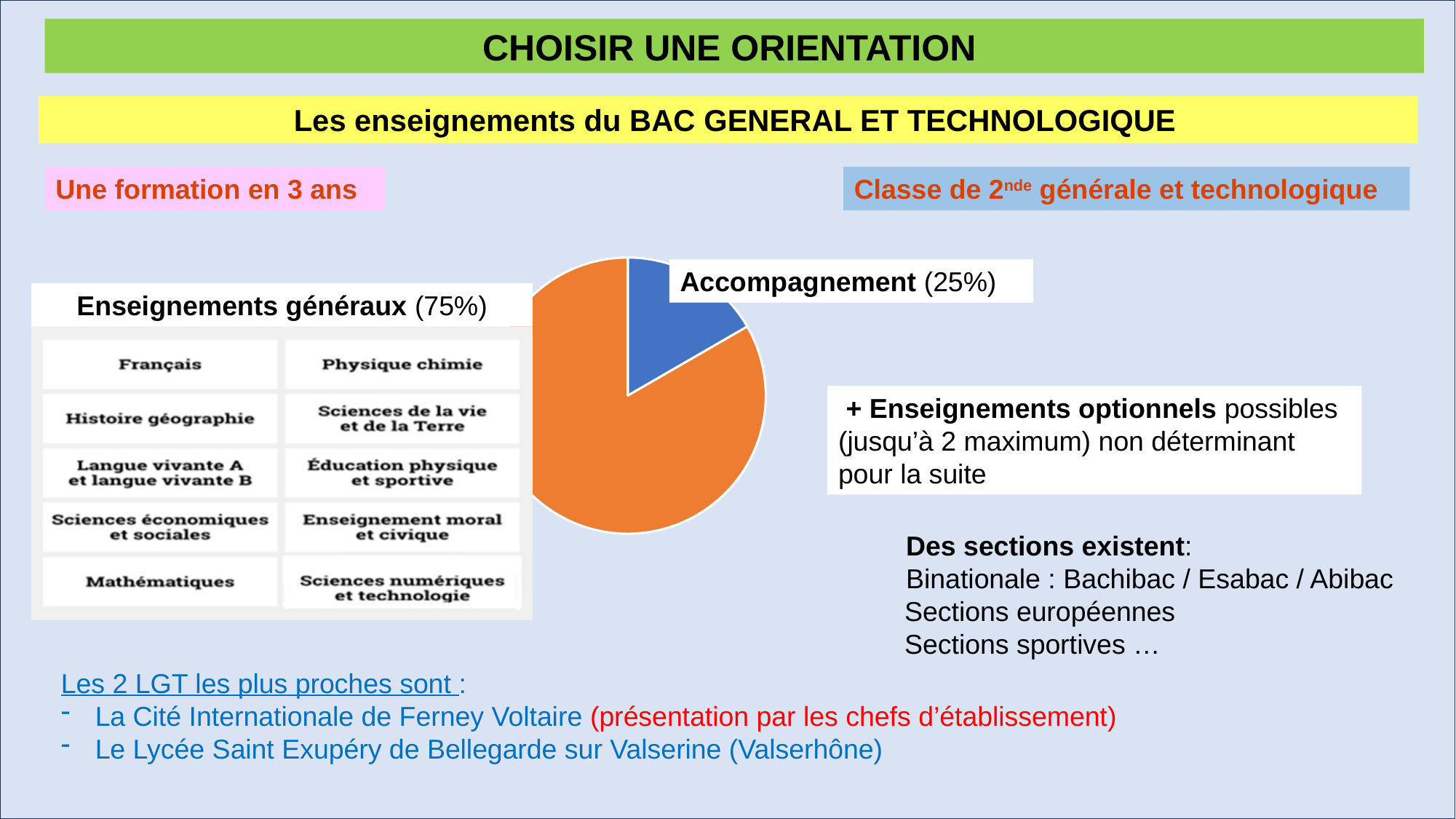
What colour is the Accompagnement slice of the pie chart? blue What kind of chart is shown on the slide? pie chart What is the difference in percentage points between Enseignements généraux and Accompagnement in the pie chart? 50 How many slices does the pie chart have? 2 What share of the pie chart is Accompagnement? 25% What colour is the Enseignements généraux slice of the pie chart? orange Which is larger in the pie chart, Enseignements généraux or Accompagnement? Enseignements généraux What is the total of the two slices shown in the pie chart? 100% What share of the pie chart is Enseignements généraux? 75% Which slice of the pie chart is the smallest? Accompagnement Which slice of the pie chart is the largest? Enseignements généraux